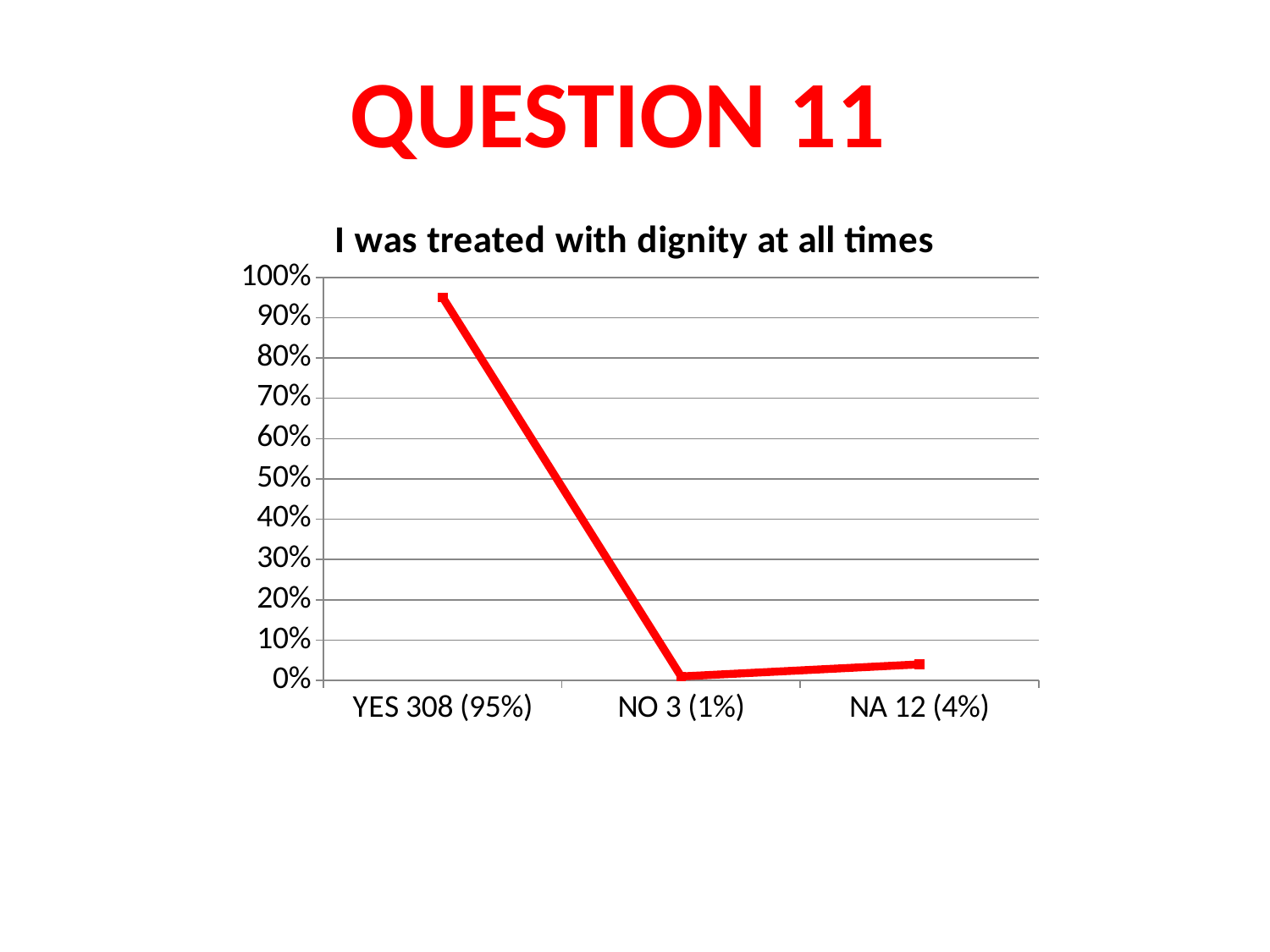
What kind of chart is shown on the slide? line chart What percentage of responses were YES? 95% How many categories are plotted on the x axis? 3 How many respondents answered YES? 308 How many respondents answered NA? 12 What percentage of responses were NA? 4% What percentage of responses were NO? 1% Which category has the lowest value? NO What is the difference in percentage points between YES and NA? 91% What is the title of the chart? I was treated with dignity at all times Which category has the highest value? YES Is the value for YES greater or less than 90%? greater